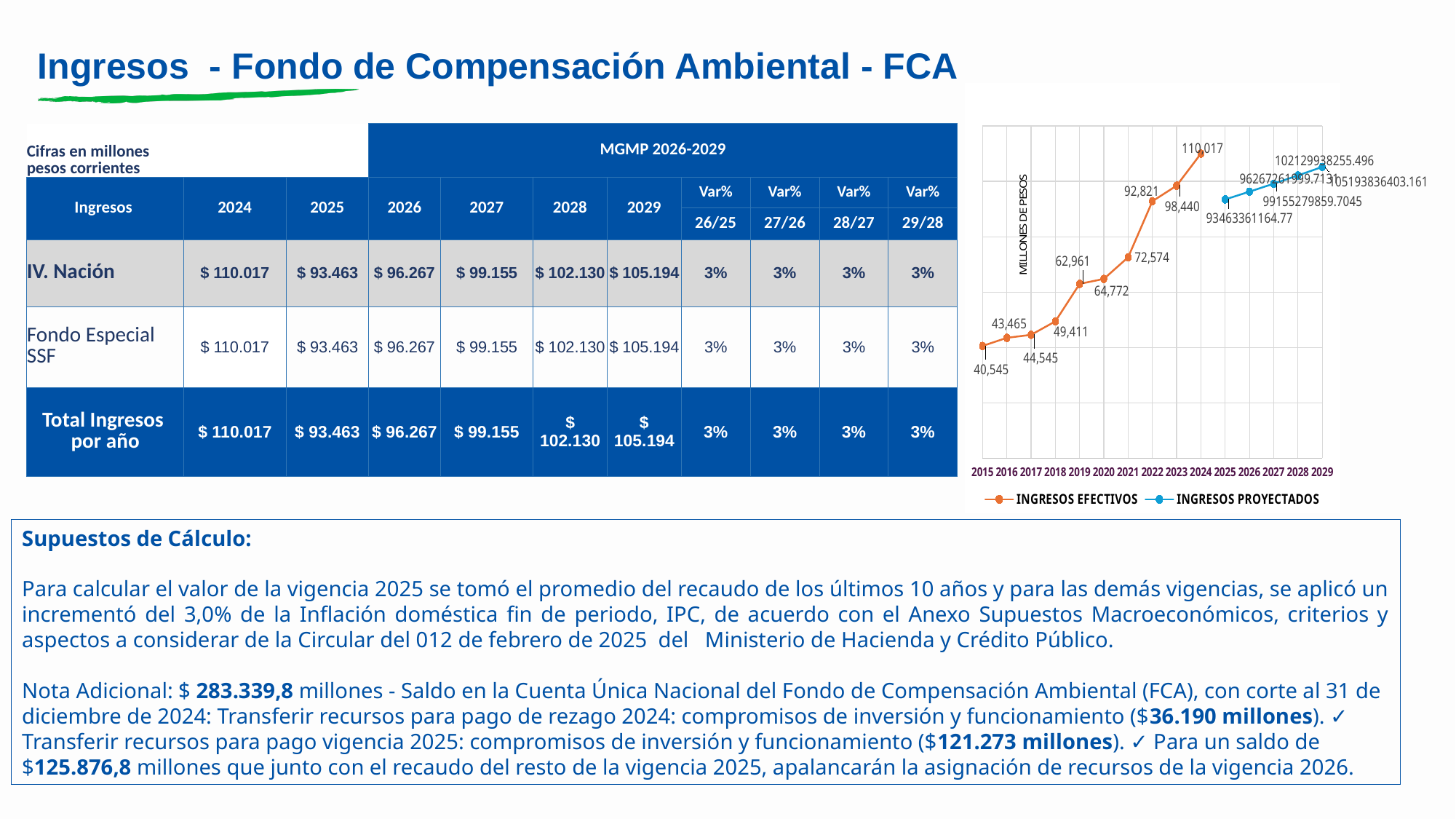
What kind of chart is shown on the right side of the slide? line chart How many series does the legend of the line chart list? 2 In the line chart, what is the INGRESOS EFECTIVOS value for 2019? 62,961 In the line chart, what is the difference between the INGRESOS EFECTIVOS values for 2024 and 2023? 11,577 In the line chart, which year has the larger INGRESOS EFECTIVOS value, 2020 or 2021? 2021 In the line chart, what is the INGRESOS EFECTIVOS value for 2015? 40,545 In the line chart, which year has the lowest INGRESOS EFECTIVOS value? 2015 In the line chart, which year has the highest INGRESOS EFECTIVOS value? 2024 In the line chart, do the INGRESOS EFECTIVOS values generally rise or fall from 2015 to 2024? rise In the line chart, what is the INGRESOS EFECTIVOS value for 2022? 92,821 In the line chart, what is the INGRESOS EFECTIVOS value for 2024? 110,017 What are the two series names shown in the legend of the line chart? INGRESOS EFECTIVOS and INGRESOS PROYECTADOS